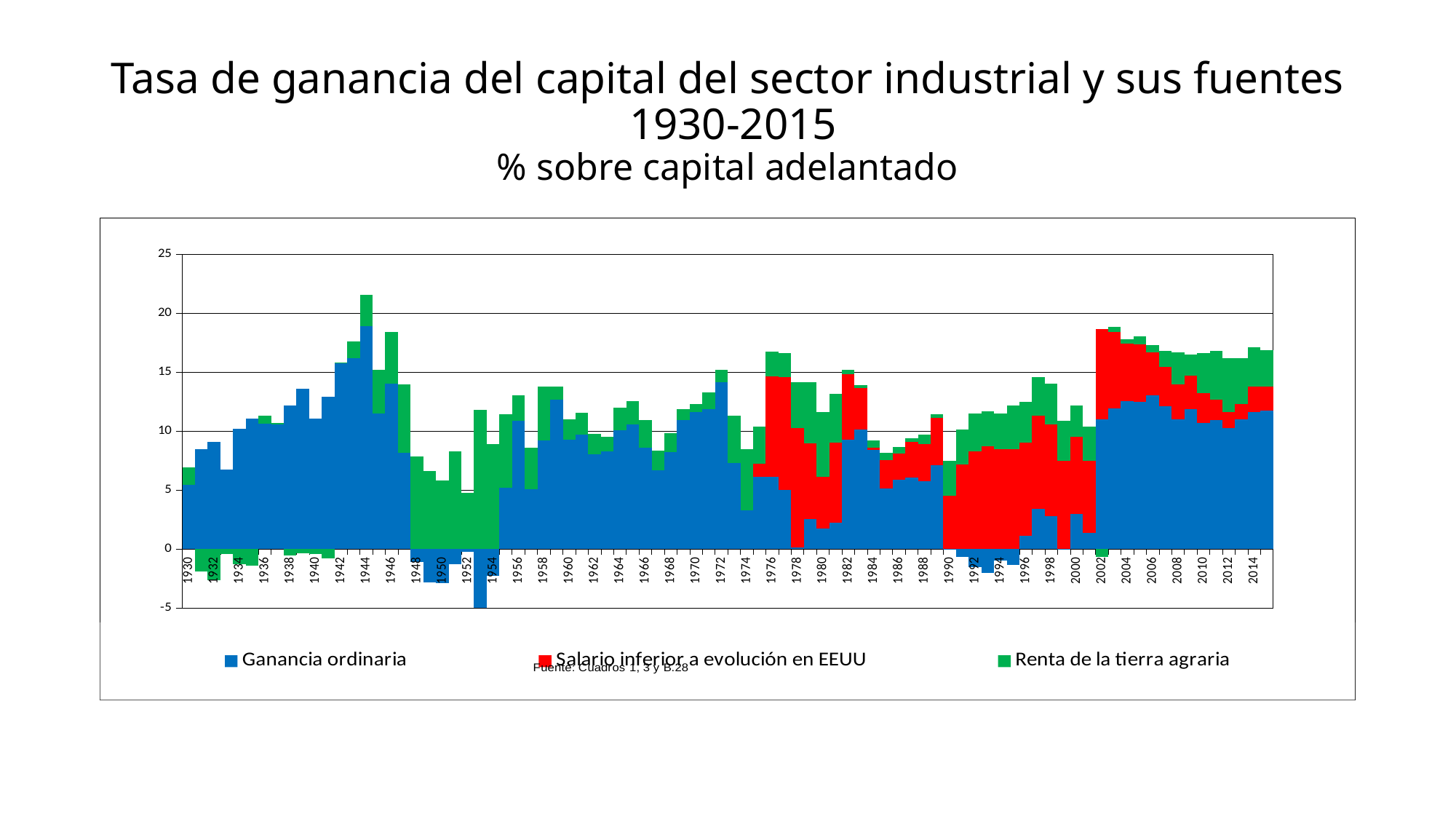
Is the total stacked value for 2003 greater or less than 15? greater Is the value of 'Ganancia ordinaria' for 2005 greater or less than 10? greater What kind of chart is shown on the slide? stacked bar chart Which year has the larger total stacked bar, 1930 or 1944? 1944 How many series does the legend list? 3 Is the value of 'Ganancia ordinaria' for 1954 greater or less than 0? less Which year has the highest total stacked bar? 1944 Which colour represents the series 'Ganancia ordinaria'? blue What are the three series named in the legend? Ganancia ordinaria, Salario inferior a evolución en EEUU, Renta de la tierra agraria Do the total stacked values generally rise or fall from 1930 to 1944? rise